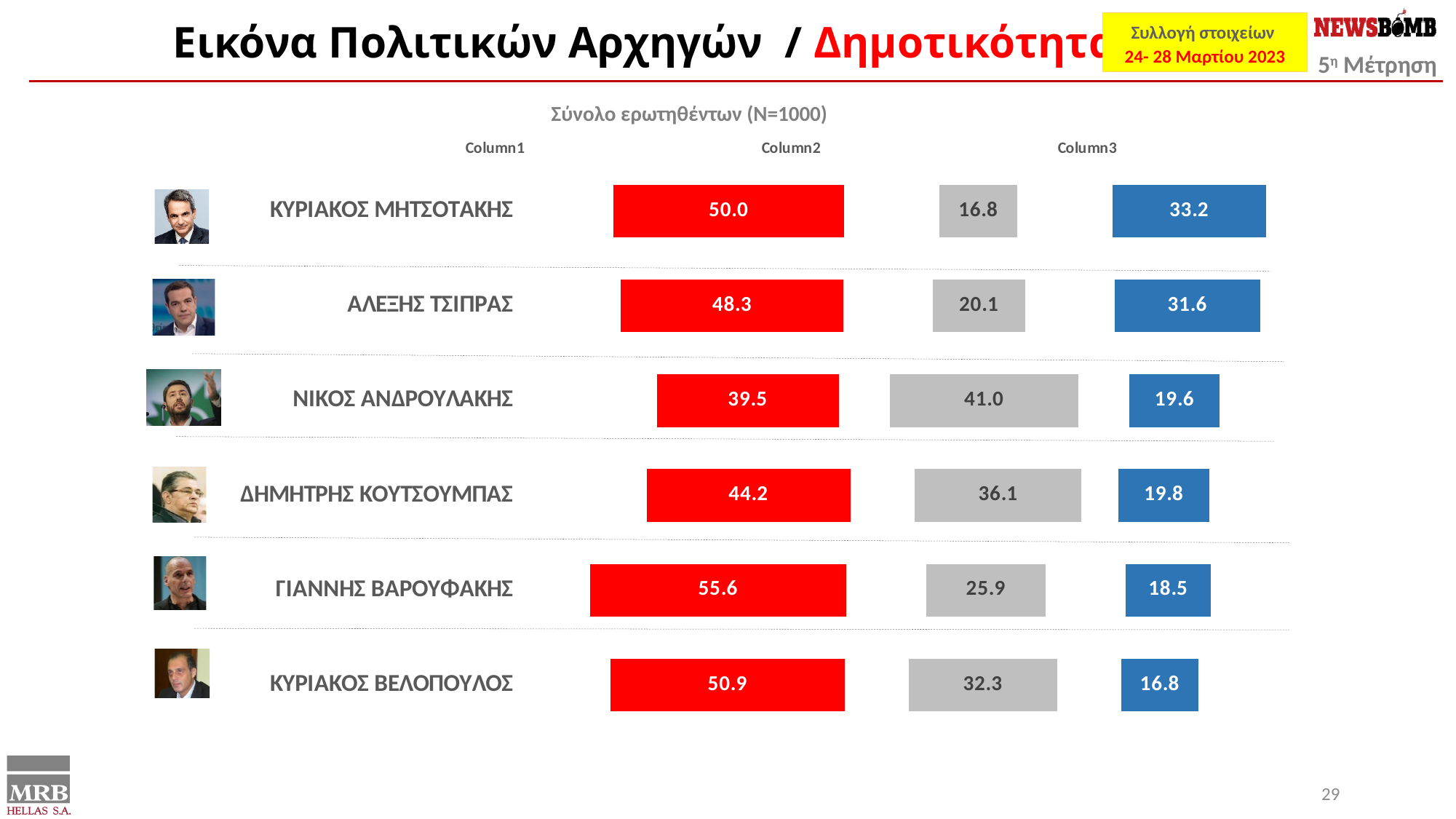
What kind of chart is shown on the slide? Bar chart How many series does the chart show? 3 How many people are shown in the chart? 6 What is the total of the three values for ΚΥΡΙΑΚΟΣ ΜΗΤΣΟΤΑΚΗΣ? 100.0